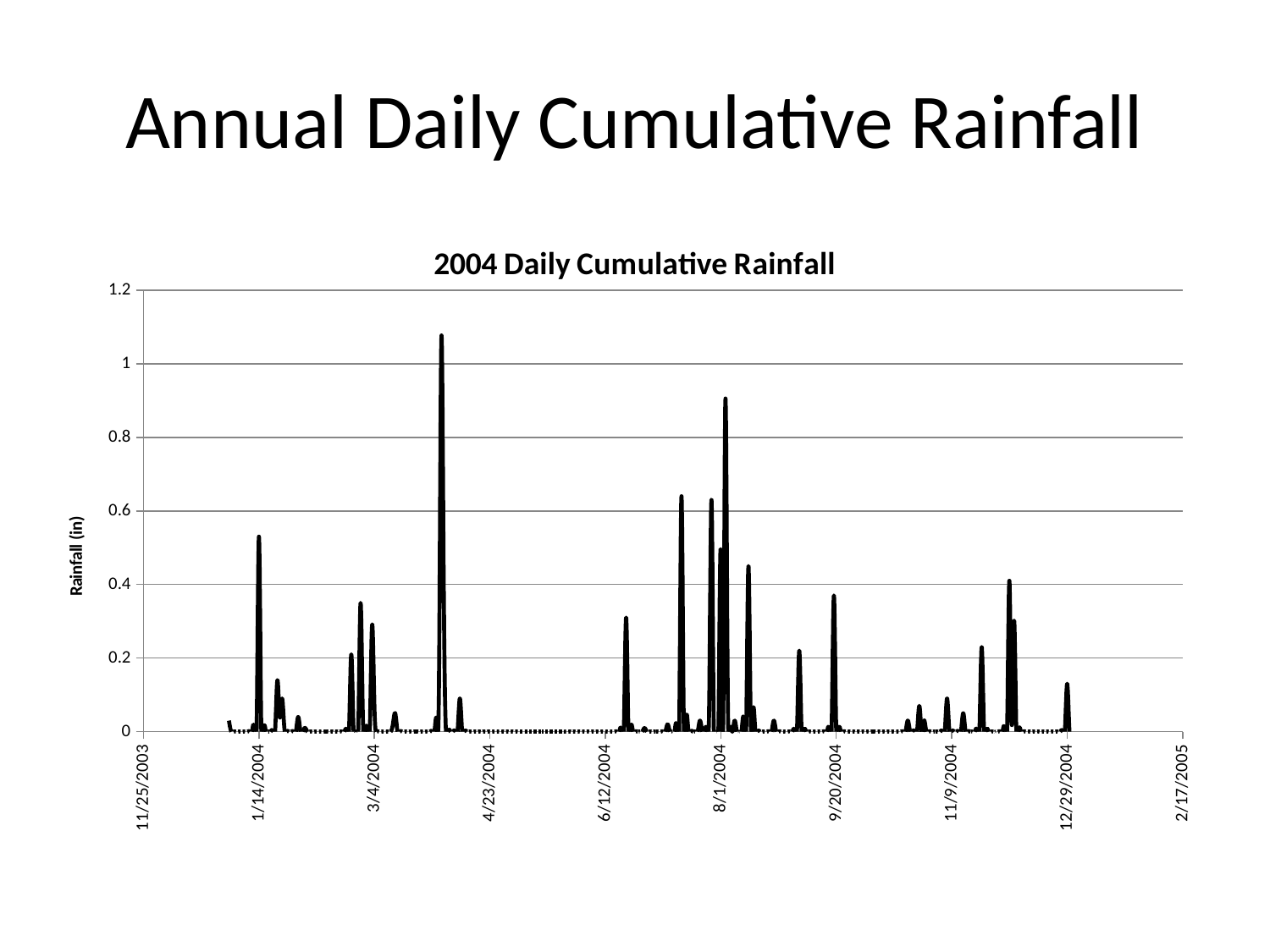
What is the label on the vertical axis of the chart? Rainfall (in) What is the title of the chart? 2004 Daily Cumulative Rainfall How many date tick labels are shown on the horizontal axis? 10 Is the highest spike on the chart greater or less than 1? greater Is the spike near the 1/14/2004 tick greater or less than 0.4? greater Is the spike near the 9/20/2004 tick greater or less than 0.6? less What kind of chart is shown on the slide? Line chart Which is larger: the tallest spike near 8/1/2004 or the spike near 9/20/2004? The tallest spike near 8/1/2004 What is the highest value shown on the vertical axis? 1.2 Which is larger: the spike near 1/14/2004 or the spike near 12/29/2004? The spike near 1/14/2004